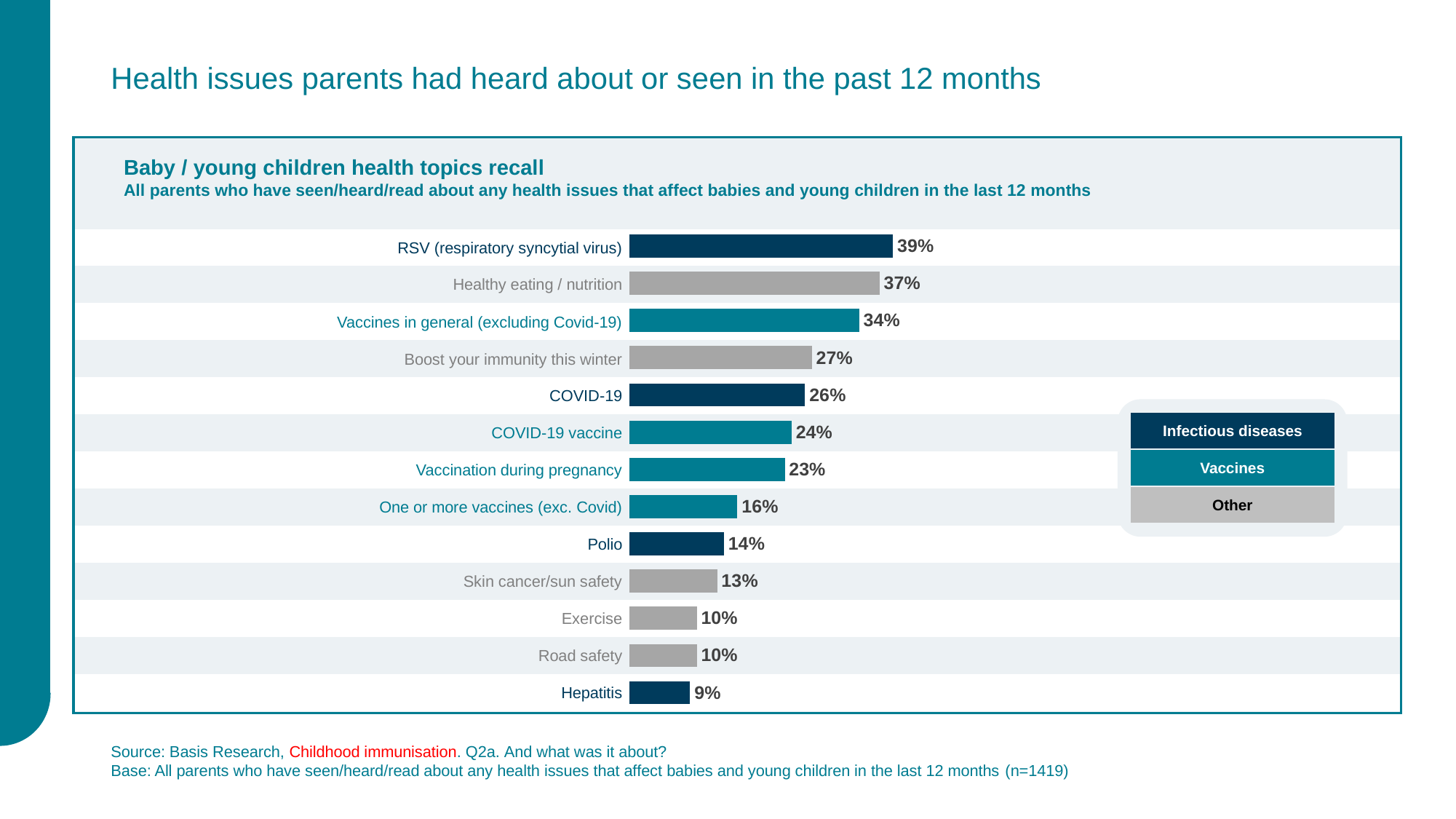
What percentage of parents recalled RSV (respiratory syncytial virus)? 39% What is the difference between Vaccines in general (excluding Covid-19) and One or more vaccines (exc. Covid)? 18% Which legend category does the Boost your immunity this winter bar belong to? Other Which health topic has the highest recall? RSV (respiratory syncytial virus) How many categories does the legend list? 3 What percentage is shown for Skin cancer/sun safety? 13% Which health topic has the lowest recall? Hepatitis What is the value for Vaccination during pregnancy? 23% Which is larger, the value for COVID-19 vaccine or the value for Polio? COVID-19 vaccine How many health topics are listed in the chart? 13 What type of chart is shown on the slide? Bar chart What is the difference between the values for Healthy eating / nutrition and COVID-19? 11%